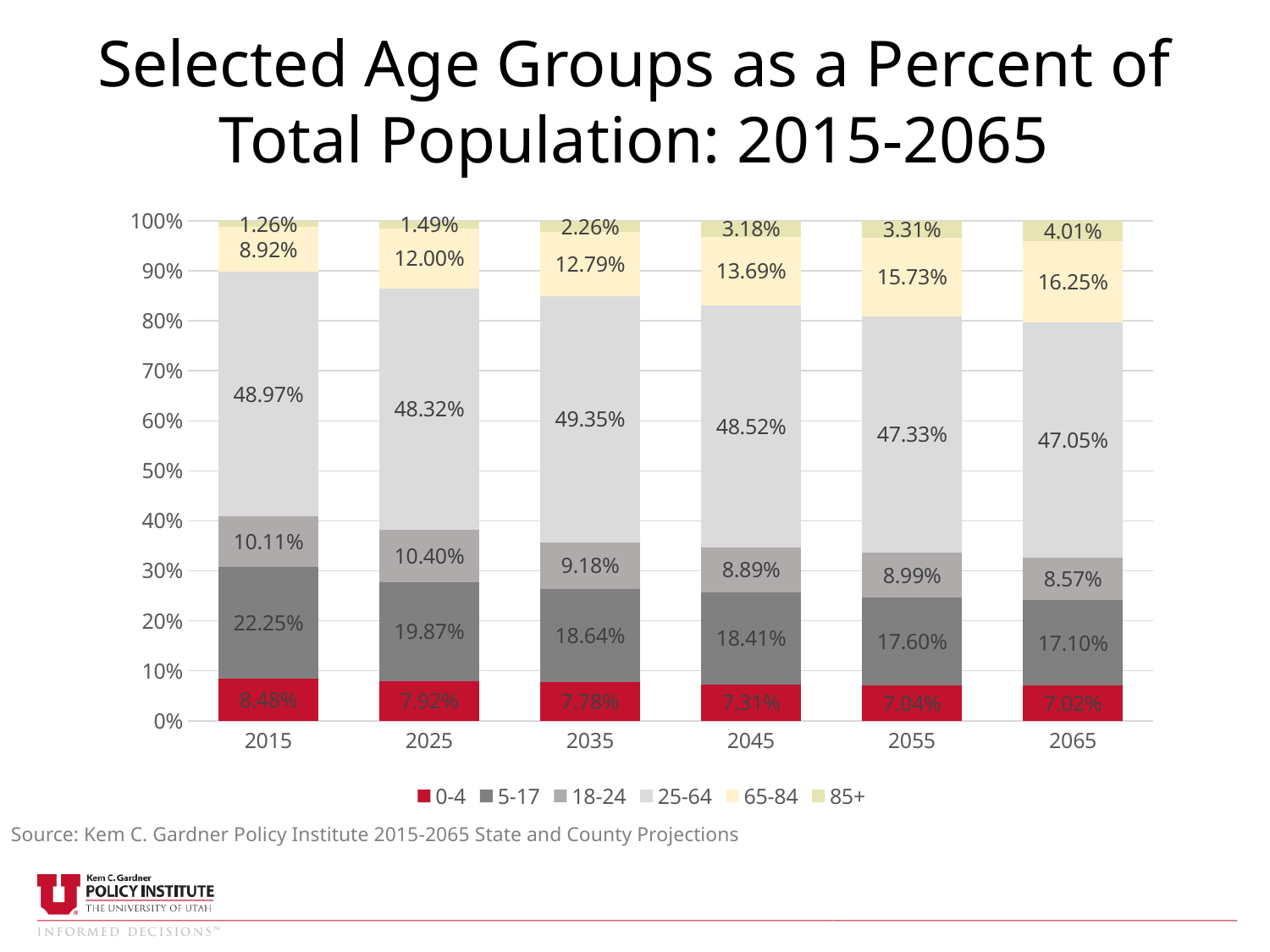
In which year is the 65-84 age group share highest? 2065 What is the value for the 0-4 age group in 2015? 8.48% Does the 0-4 age group share rise or fall from 2015 to 2065? Fall What is the value for the 85+ age group in 2065? 4.01% In which year is the 5-17 age group share lowest? 2065 What is the difference between the 5-17 share in 2015 and in 2065? 5.15% What is the value for the 65-84 age group in 2055? 15.73% How many years are shown on the x axis? 6 What kind of chart is shown on the slide? Stacked bar chart Which is larger, the 18-24 share in 2025 or in 2045? 2025 How many age groups does the legend list? 6 What percent of the total population is the 25-64 age group in 2035? 49.35%